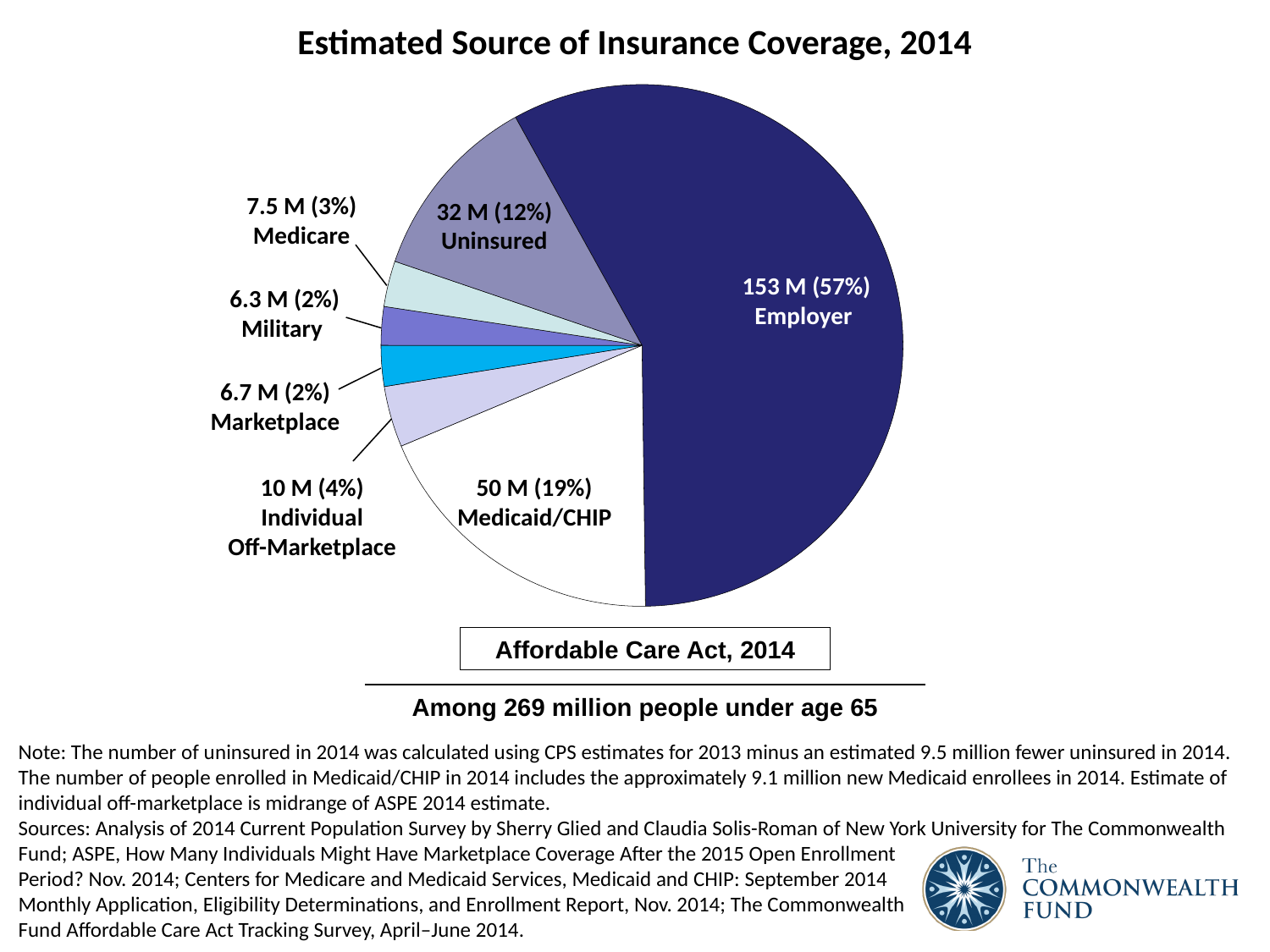
What percentage of people have Medicare coverage? 3% How many slices does the pie chart have? 7 What share of the pie is Medicaid/CHIP? 19% Which is larger, Individual Off-Marketplace or Marketplace coverage? Individual Off-Marketplace Which source of coverage has the largest slice? Employer Which source of coverage has the smallest slice? Military What is the difference in millions between Employer and Medicaid/CHIP coverage? 103 M How many people are estimated to have Employer coverage? 153 M How many people in total does the chart cover, according to the text below it? 269 million What kind of chart is shown on the slide? Pie chart What is the title of the chart? Estimated Source of Insurance Coverage, 2014 How many people are Uninsured according to the chart? 32 M